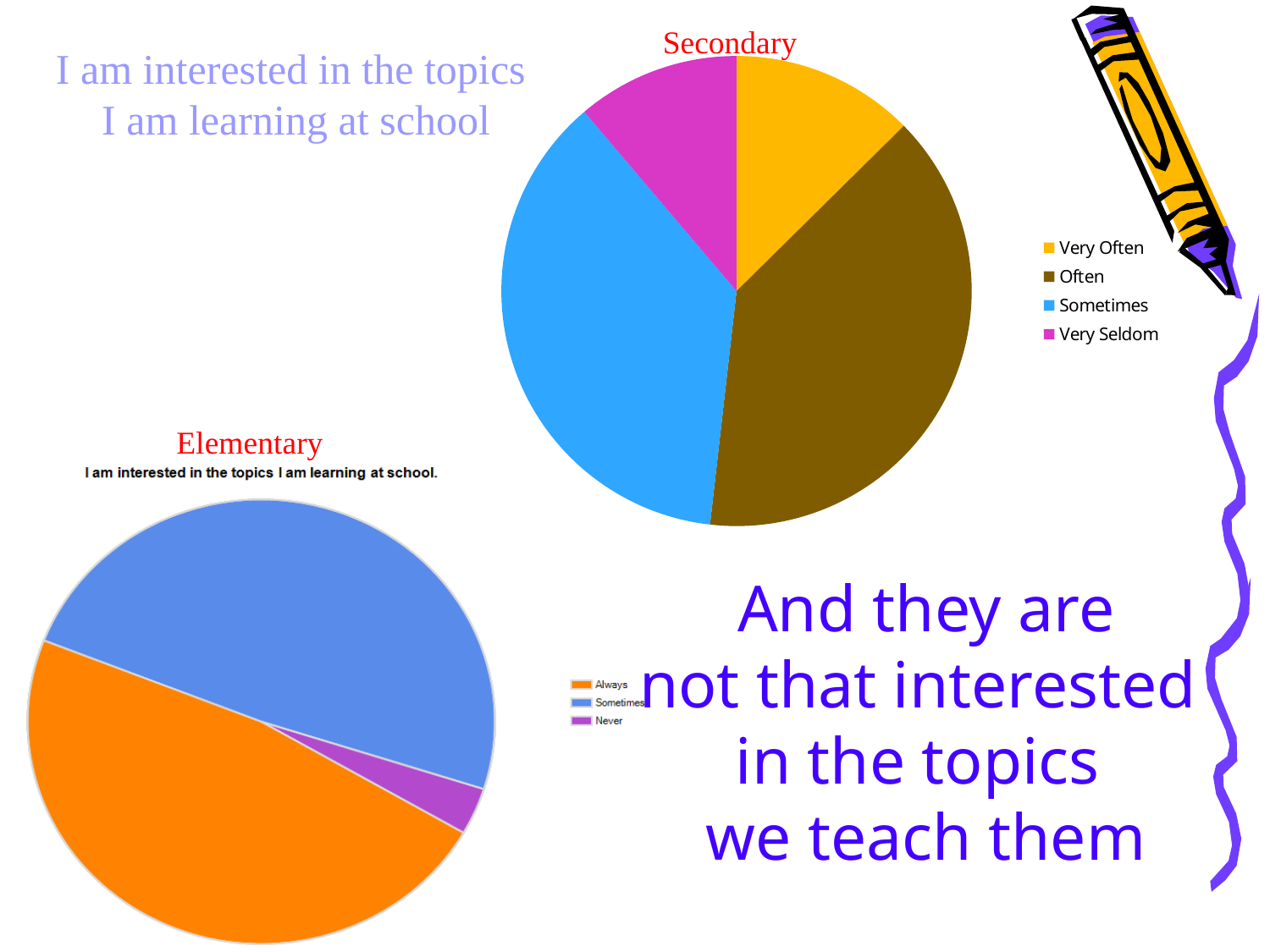
What kind of chart is the Elementary chart? pie chart What kind of chart is the Secondary chart? pie chart In the Secondary chart, which category has the largest slice? Often In the Elementary chart, which category has the smallest slice? Never In the Elementary chart, what colour is the Always slice? orange In the Elementary chart, which slice is larger, Always or Never? Always In the Secondary chart, how many categories does the legend list? 4 In the Elementary chart, how many slices does the pie have? 3 In the Secondary chart, how many slices does the pie have? 4 In the Secondary chart, which slice is larger, Often or Very Seldom? Often In the Secondary chart, what colour is the Sometimes slice? blue In the Elementary chart, how many categories does the legend list? 3